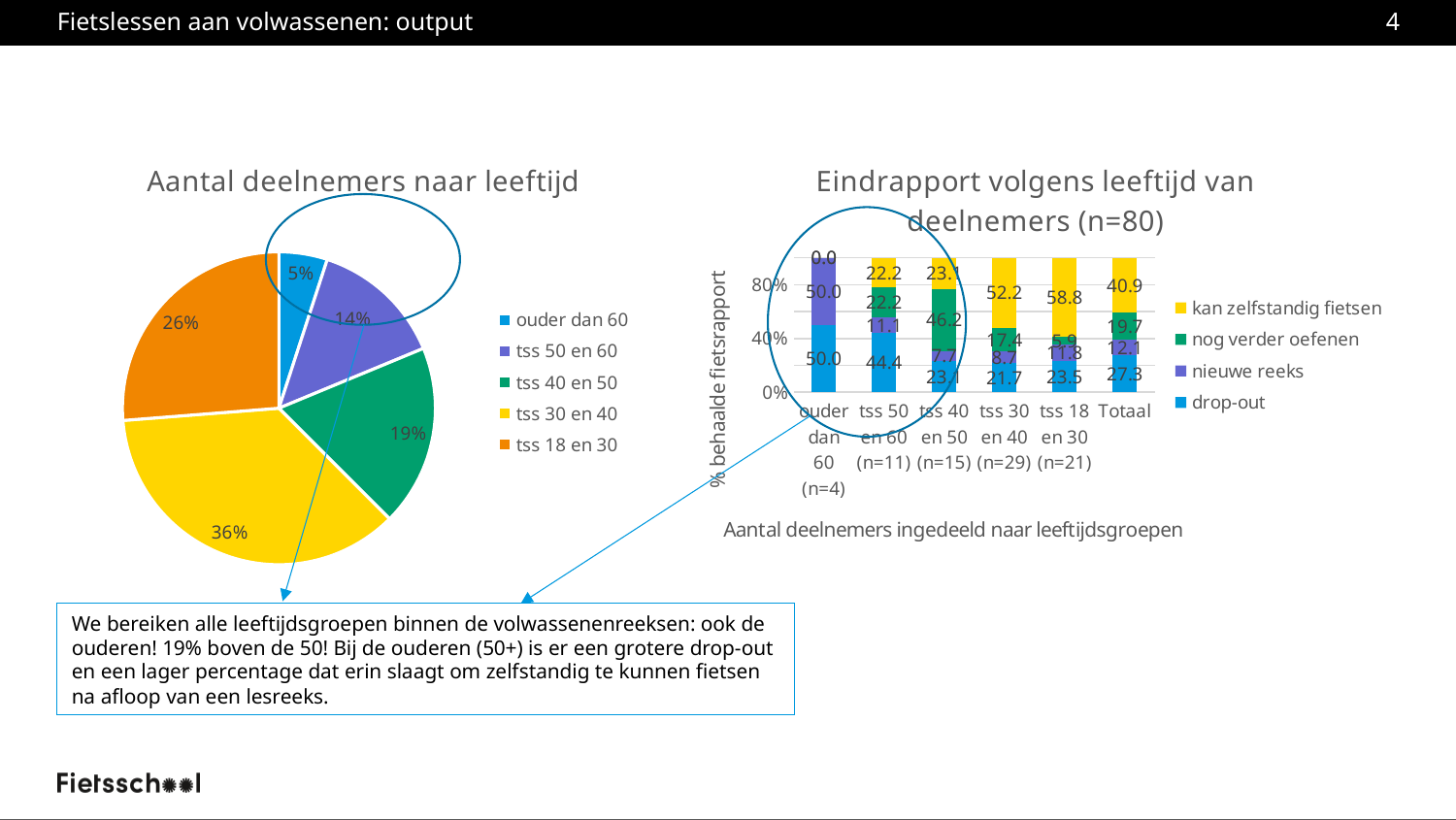
How many series does the legend of the chart 'Eindrapport volgens leeftijd van deelnemers (n=80)' list? 4 How many slices does the pie chart 'Aantal deelnemers naar leeftijd' have? 5 In the chart 'Eindrapport volgens leeftijd van deelnemers (n=80)', what is the 'kan zelfstandig fietsen' value for 'tss 18 en 30'? 58.8 In the pie chart 'Aantal deelnemers naar leeftijd', what percentage of participants are in the 'tss 30 en 40' group? 36% In the chart 'Eindrapport volgens leeftijd van deelnemers (n=80)', what is the 'drop-out' value for 'Totaal'? 27.3 In the chart 'Eindrapport volgens leeftijd van deelnemers (n=80)', what is the 'nog verder oefenen' value for 'tss 40 en 50'? 46.2 In the pie chart 'Aantal deelnemers naar leeftijd', which age group has the smallest share? ouder dan 60 What type of chart is 'Eindrapport volgens leeftijd van deelnemers (n=80)'? stacked bar chart In the chart 'Eindrapport volgens leeftijd van deelnemers (n=80)', which age group has the highest 'drop-out' value? ouder dan 60 In the chart 'Eindrapport volgens leeftijd van deelnemers (n=80)', is the 'kan zelfstandig fietsen' value for 'tss 50 en 60' larger or smaller than for 'tss 30 en 40'? smaller In the pie chart 'Aantal deelnemers naar leeftijd', which age group has the largest share? tss 30 en 40 In the pie chart 'Aantal deelnemers naar leeftijd', what is the difference in percentage points between 'tss 18 en 30' and 'tss 40 en 50'? 7